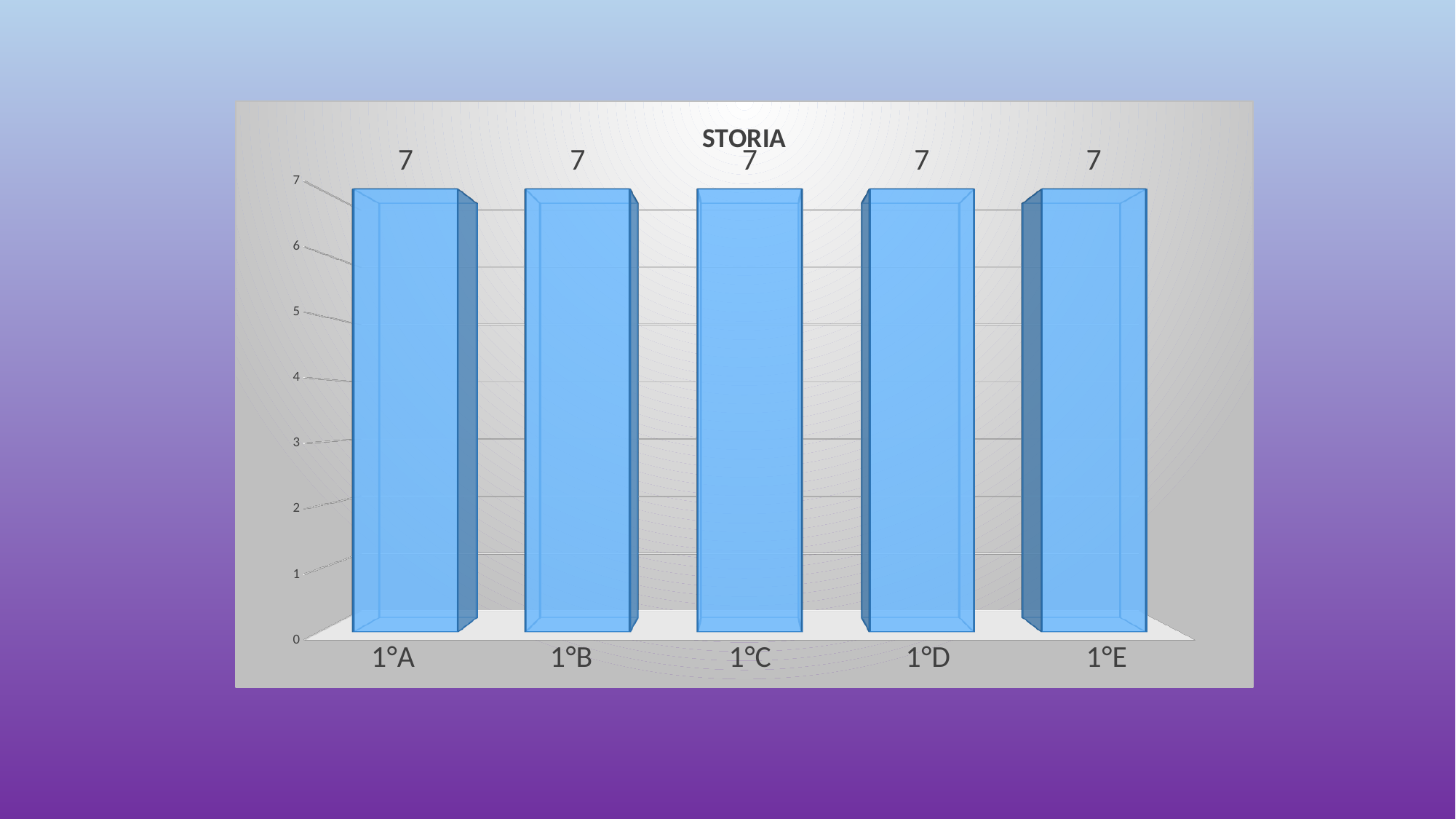
What is the value for 1°A? 7 Do the values rise, fall or stay the same from 1°A to 1°E? stay the same What kind of chart is shown? bar chart What is the value for 1°E? 7 Is the value for 1°B greater or less than 5? greater What is the value for 1°C? 7 What is the highest value shown on the vertical axis? 7 What is the title of the chart? STORIA How many categories are shown on the x axis? 5 What is the difference between the values for 1°B and 1°D? 0